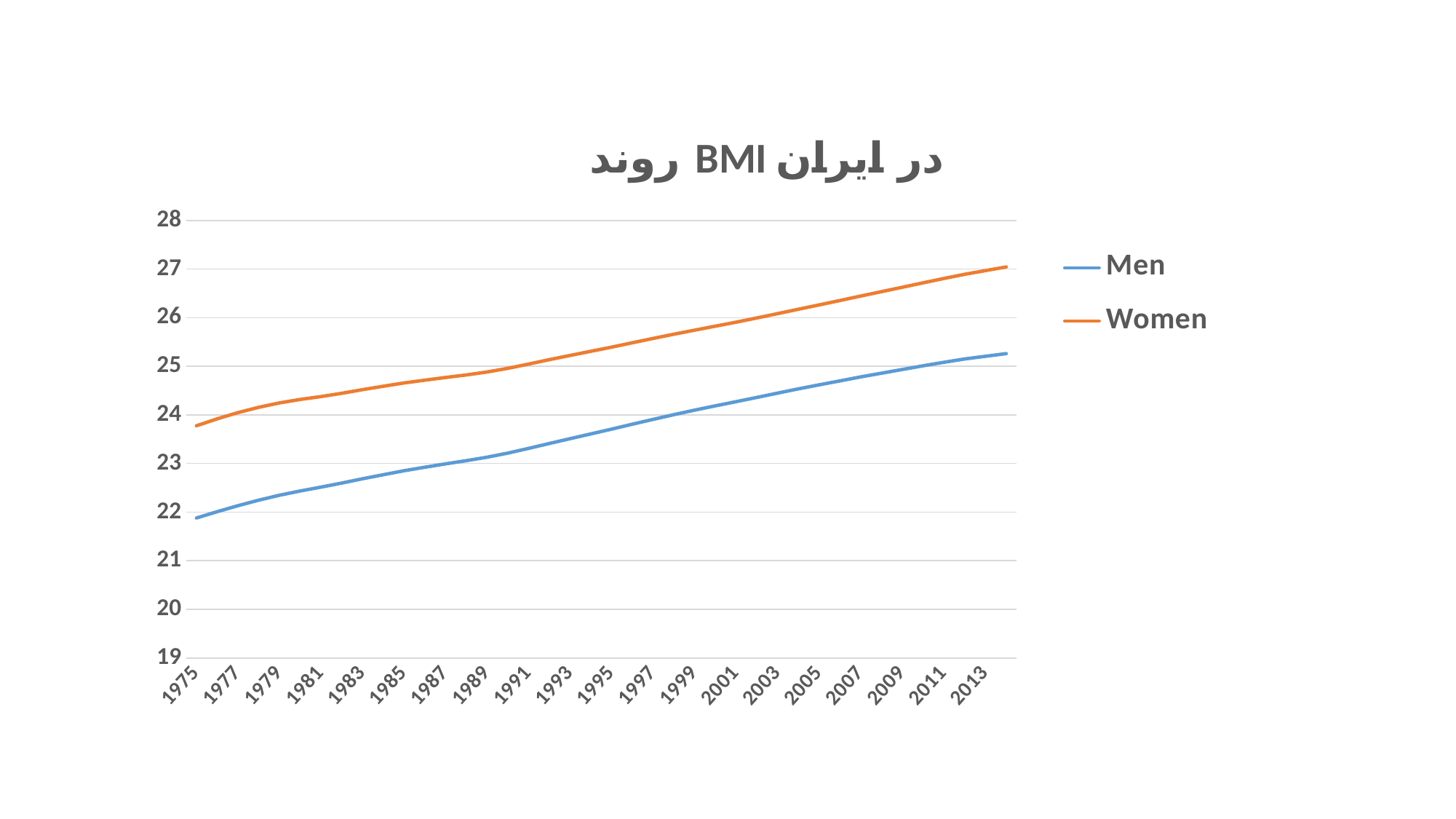
Do the values for Men rise or fall from 1975 to 2013? rise Is the value for Women in 2009 greater or less than 26? greater Is the value for Women in 1975 greater or less than 24? less How many year labels are shown on the x axis? 20 Is the value for Men in 2013 greater or less than 25? greater Which series does the legend list besides Men? Women Do the values for Women rise or fall from 1975 to 2013? rise What kind of chart is shown on the slide? line chart Which series has the higher value in 1995, Men or Women? Women What colour is the Women line? orange How many series does the legend list? 2